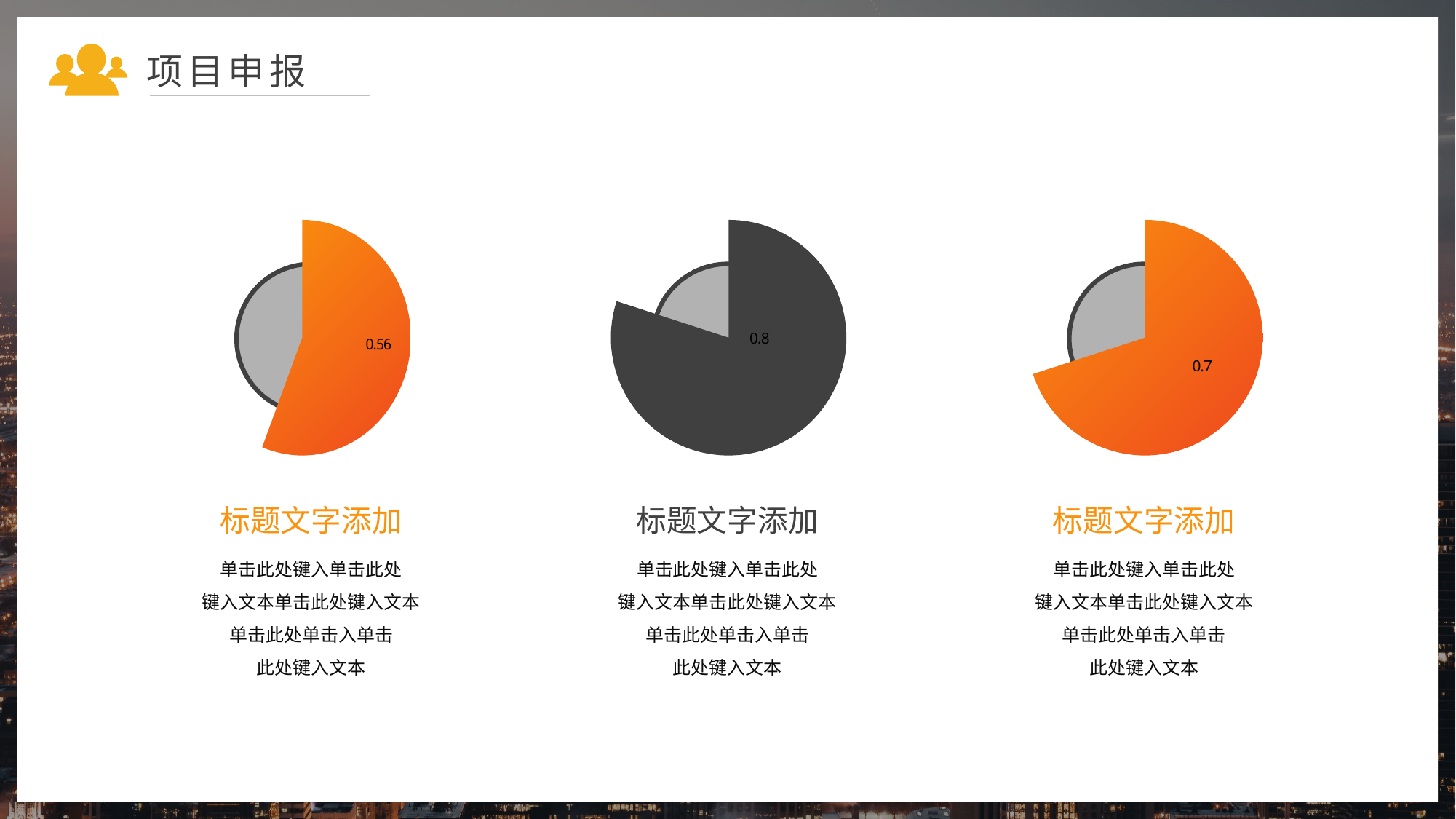
Across the three pie charts, which chart has the lowest labeled value? The left chart (0.56) Across the three pie charts, which chart has the highest labeled value? The middle chart (0.8) What kind of chart is shown in the left position on the slide? Pie chart In the middle pie chart, what value is printed on the large dark slice? 0.8 Which is larger: the labeled value in the left pie chart or the labeled value in the right pie chart? The right pie chart (0.7) How many slices does the middle pie chart have? 2 What is the difference between the labeled value in the middle pie chart and the labeled value in the right pie chart? 0.1 In the left pie chart, what value is printed on the large orange slice? 0.56 What colour is the large labeled slice in the middle pie chart? Dark grey What is the difference between the labeled value in the middle pie chart and the labeled value in the left pie chart? 0.24 How many pie charts are shown on the slide? 3 In the right pie chart, what value is printed on the large orange slice? 0.7